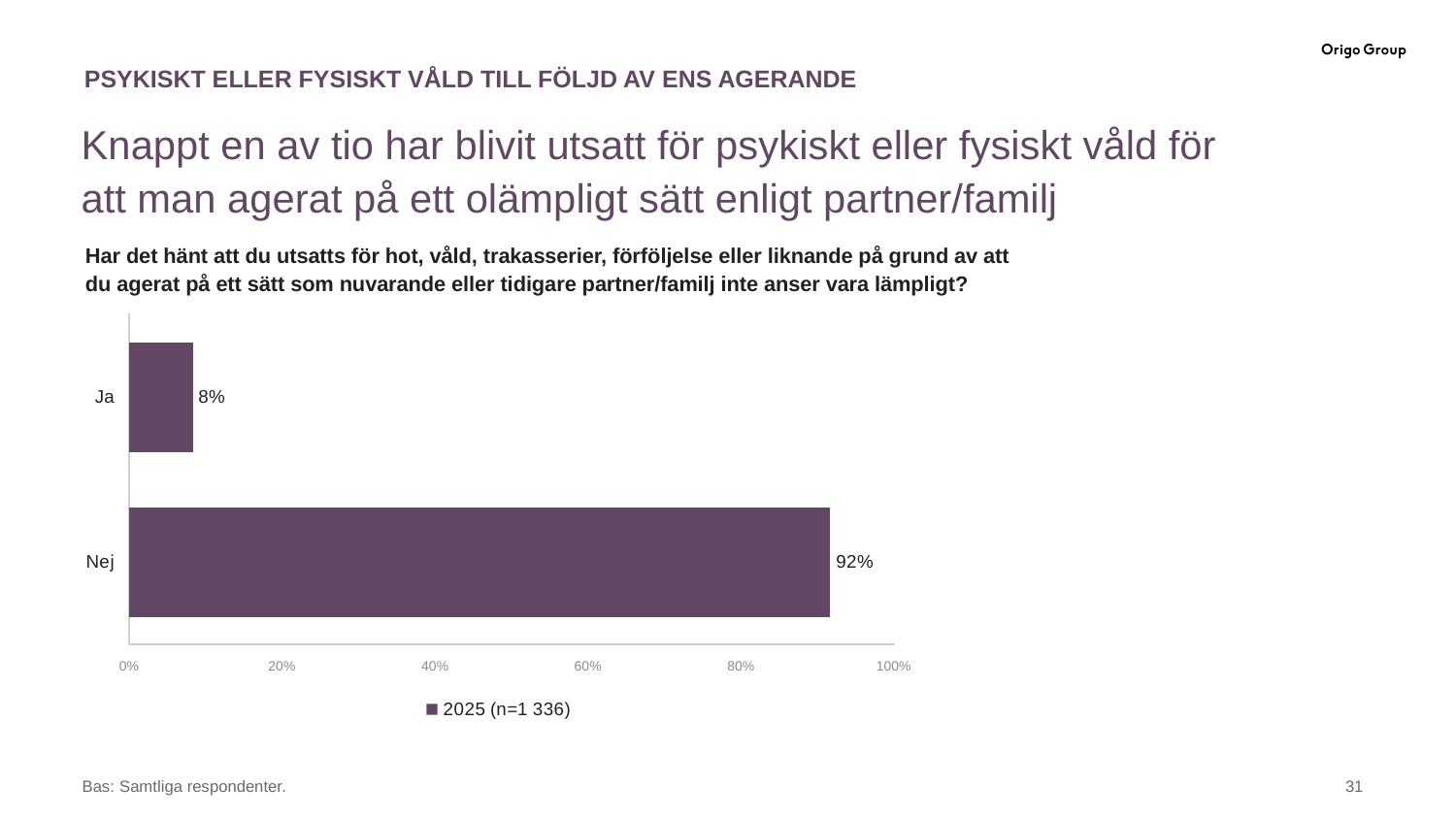
How many categories are shown in the chart? 2 What is the value for "Nej"? 92% Which is larger, the value for "Ja" or the value for "Nej"? Nej Which category has the highest value? Nej Which category has the lowest value? Ja Is the value for "Ja" greater or less than 20%? less What kind of chart is shown on the slide? Bar chart What is the value for "Ja"? 8% How many series does the legend list? 1 What is the difference between the values for "Nej" and "Ja"? 84% What is the legend entry shown below the chart? 2025 (n=1 336) Is the value for "Nej" greater or less than 80%? greater